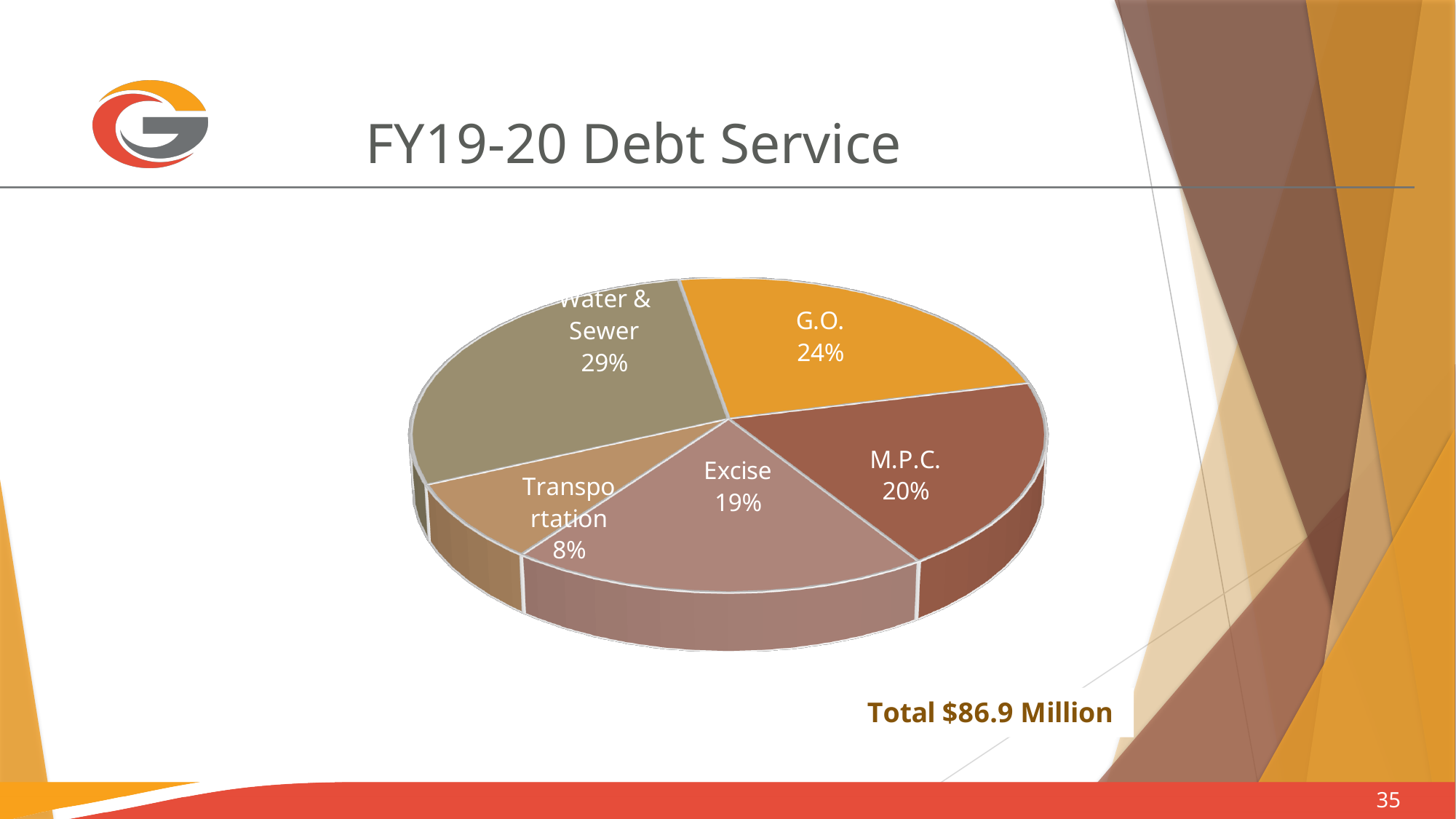
How many slices does the pie chart have? 5 Which category has the largest share of the pie? Water & Sewer What total amount is stated below the chart? Total $86.9 Million Which is larger, the share for G.O. or the share for Transportation? G.O. What share of the pie does M.P.C. represent? 20% What share of the pie does Excise represent? 19% What is the difference in percentage points between Water & Sewer and G.O.? 5 What share of the pie does Water & Sewer represent? 29% What share of the pie does Transportation represent? 8% Which category has the smallest share of the pie? Transportation What share of the pie does G.O. represent? 24% What kind of chart is shown on the slide? Pie chart